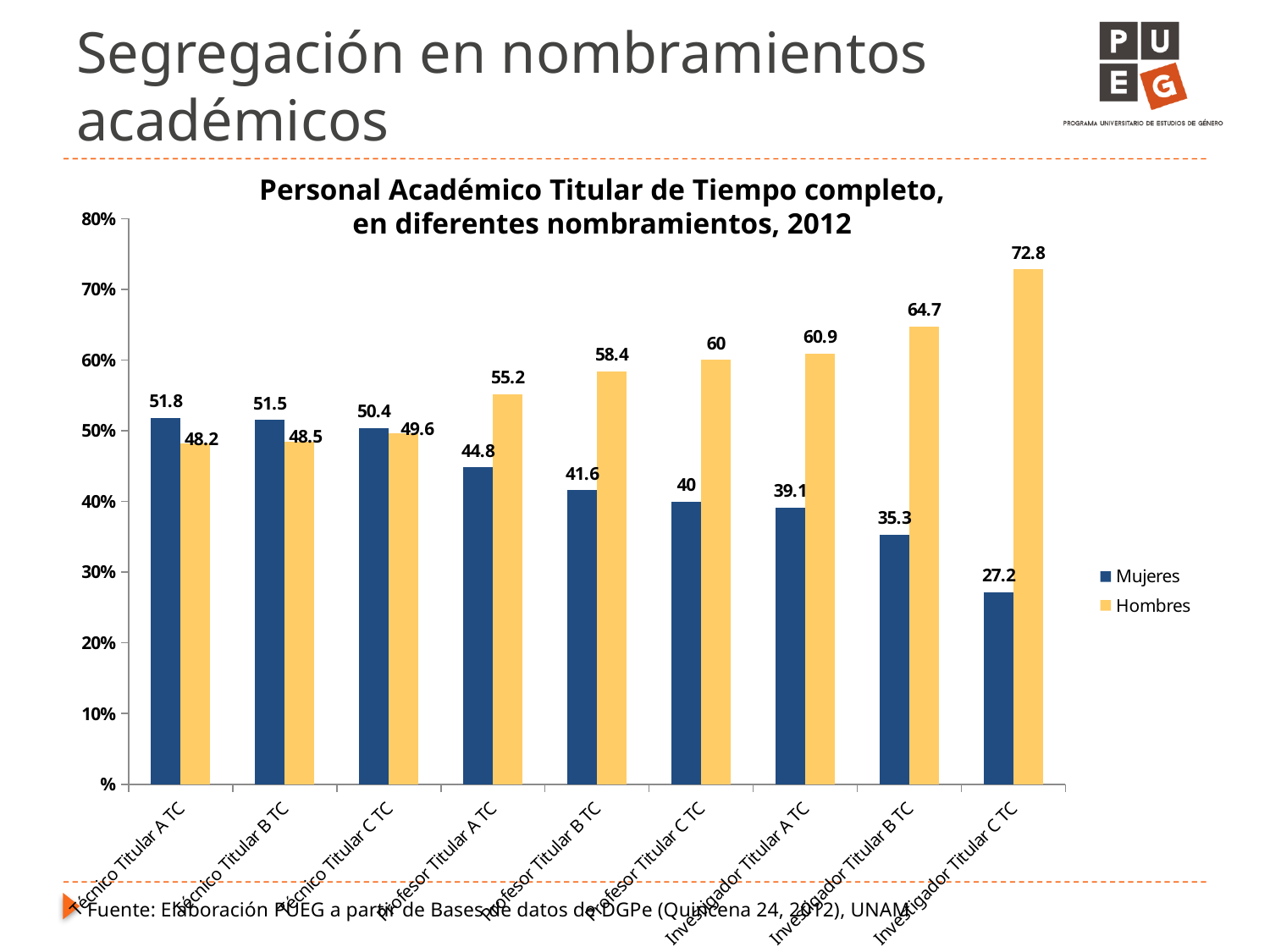
For Profesor Titular A TC, which is larger, the Mujeres value or the Hombres value? Hombres How many series does the legend list? 2 What kind of chart is shown on the slide? Bar chart What is the Mujeres value for Investigador Titular B TC? 35.3 What is the Hombres value for Investigador Titular C TC? 72.8 Which category has the lowest Mujeres value? Investigador Titular C TC What is the difference between the Hombres and Mujeres values for Investigador Titular C TC? 45.6 Do the Mujeres values rise or fall from left to right along the x axis? Fall How many categories are shown on the x axis? 9 Which category has the highest Hombres value? Investigador Titular C TC What is the Mujeres value for Técnico Titular A TC? 51.8 What is the Hombres value for Profesor Titular B TC? 58.4